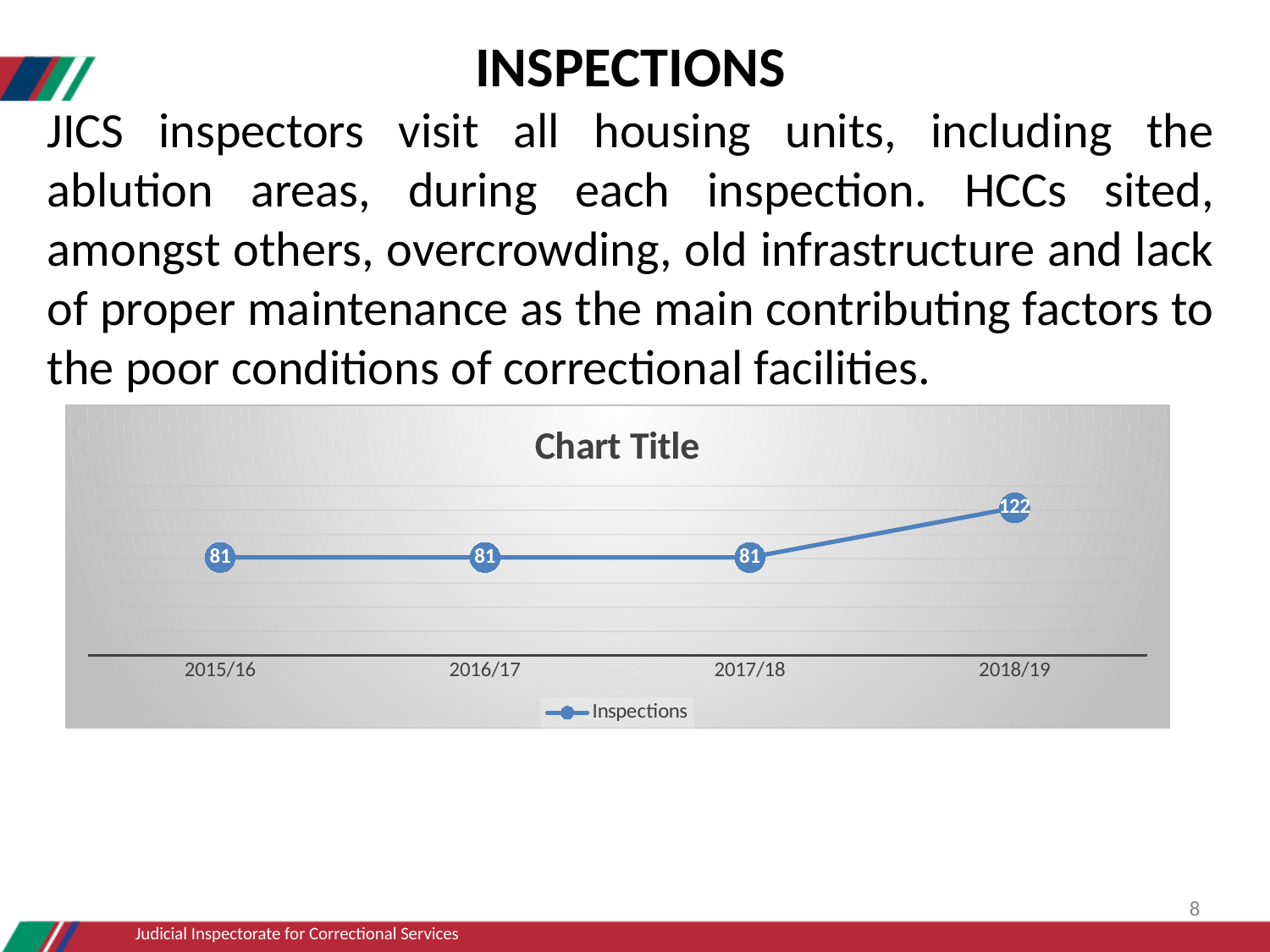
Which year has the highest number of inspections? 2018/19 Do the values rise or fall from 2017/18 to 2018/19? rise What is the value for Inspections in 2017/18? 81 What kind of chart is shown on the slide? line chart What is the title shown on the chart? Chart Title How many years are plotted on the chart? 4 What is the difference between the inspections in 2018/19 and 2017/18? 41 Which is larger, the value for 2018/19 or the value for 2016/17? 2018/19 What is the value for Inspections in 2015/16? 81 What is the value for Inspections in 2018/19? 122 How many series does the legend list? 1 What is the name of the series shown in the legend? Inspections